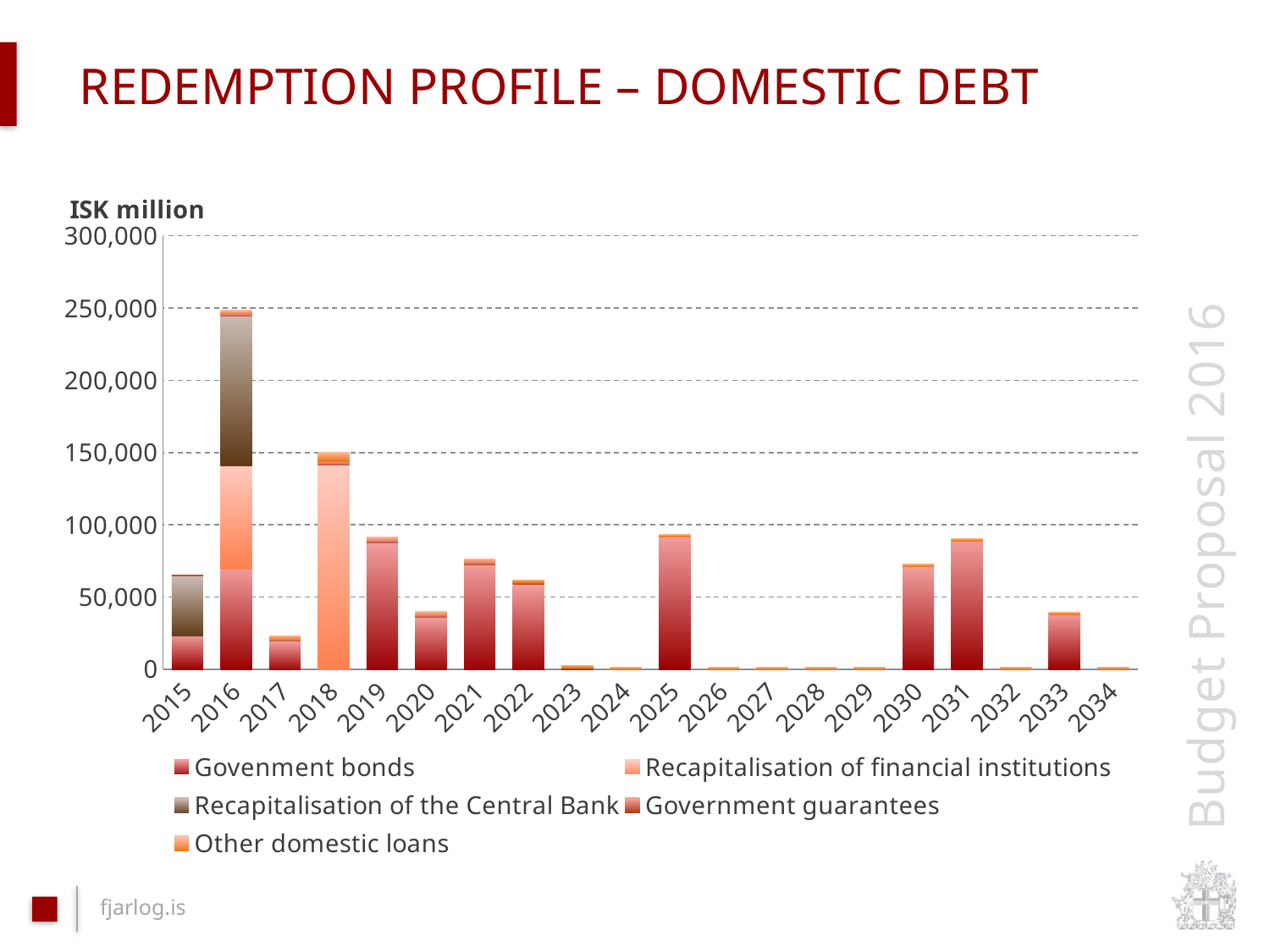
What kind of chart is shown on the slide? Stacked bar chart Is the total value for 2019 greater or less than 100,000? less Which year has the larger total, 2030 or 2031? 2031 Is the total value for 2017 greater or less than 50,000? less What is the title of the chart on the slide? REDEMPTION PROFILE – DOMESTIC DEBT Is the total value for 2016 greater or less than 200,000? greater Which year has the larger total, 2016 or 2018? 2016 What unit is given for the values on the y axis? ISK million Which year has the highest total redemption in the chart? 2016 How many series does the chart's legend list? 5 How many years are shown on the x axis of the chart? 20